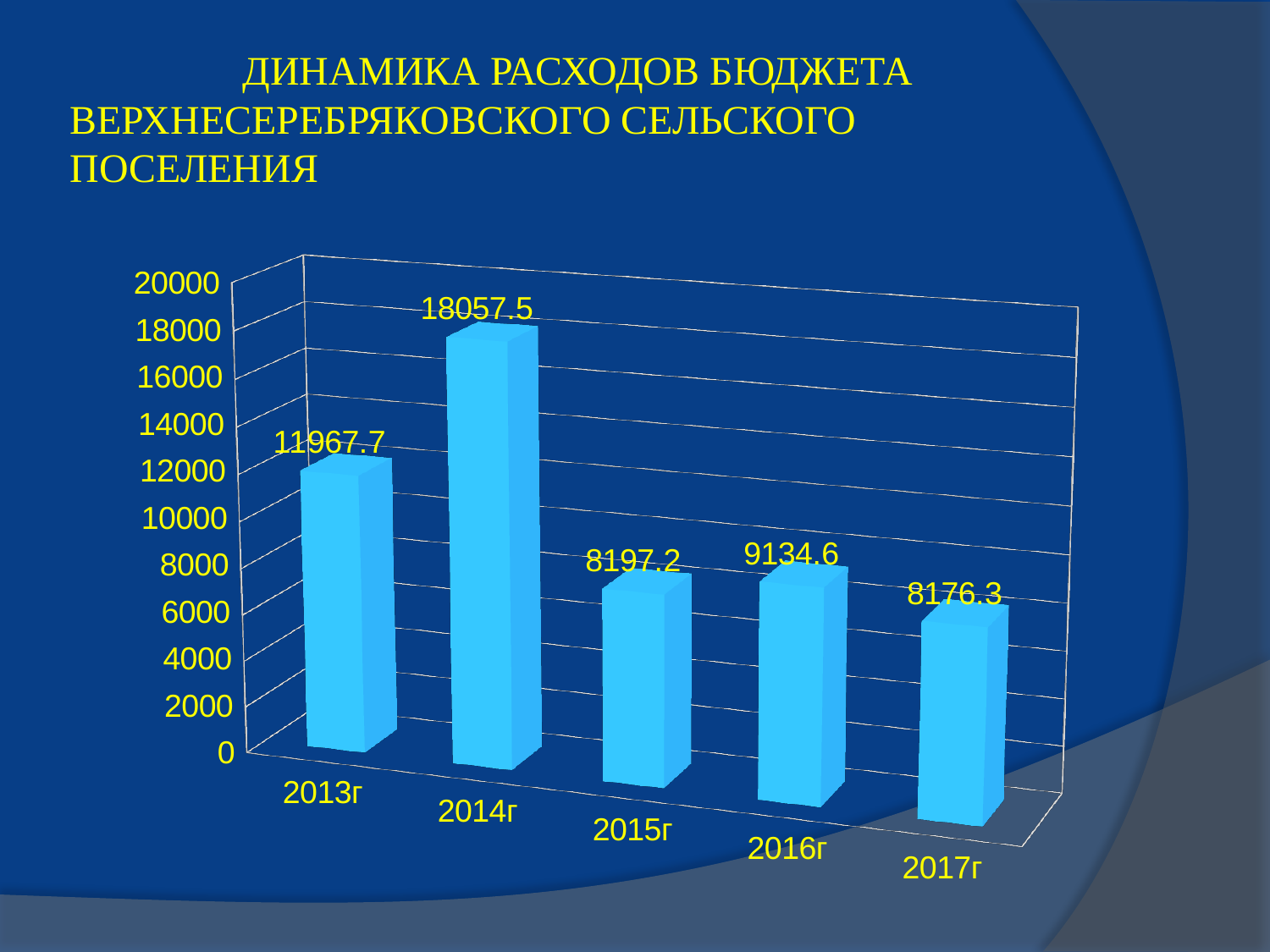
How many years are shown on the chart? 5 What is the difference between the values for 2014г and 2013г? 6089.8 Does the value rise or fall from 2014г to 2015г? fall What kind of chart is shown on the slide? bar chart What is the value for 2013г? 11967.7 What is the value for 2017г? 8176.3 Which is larger, the value for 2016г or the value for 2015г? 2016г Which year has the lowest value? 2017г Is the value for 2013г greater or less than 10000? greater Which year has the highest value? 2014г What is the difference between the values for 2016г and 2015г? 937.4 What is the value for 2014г? 18057.5